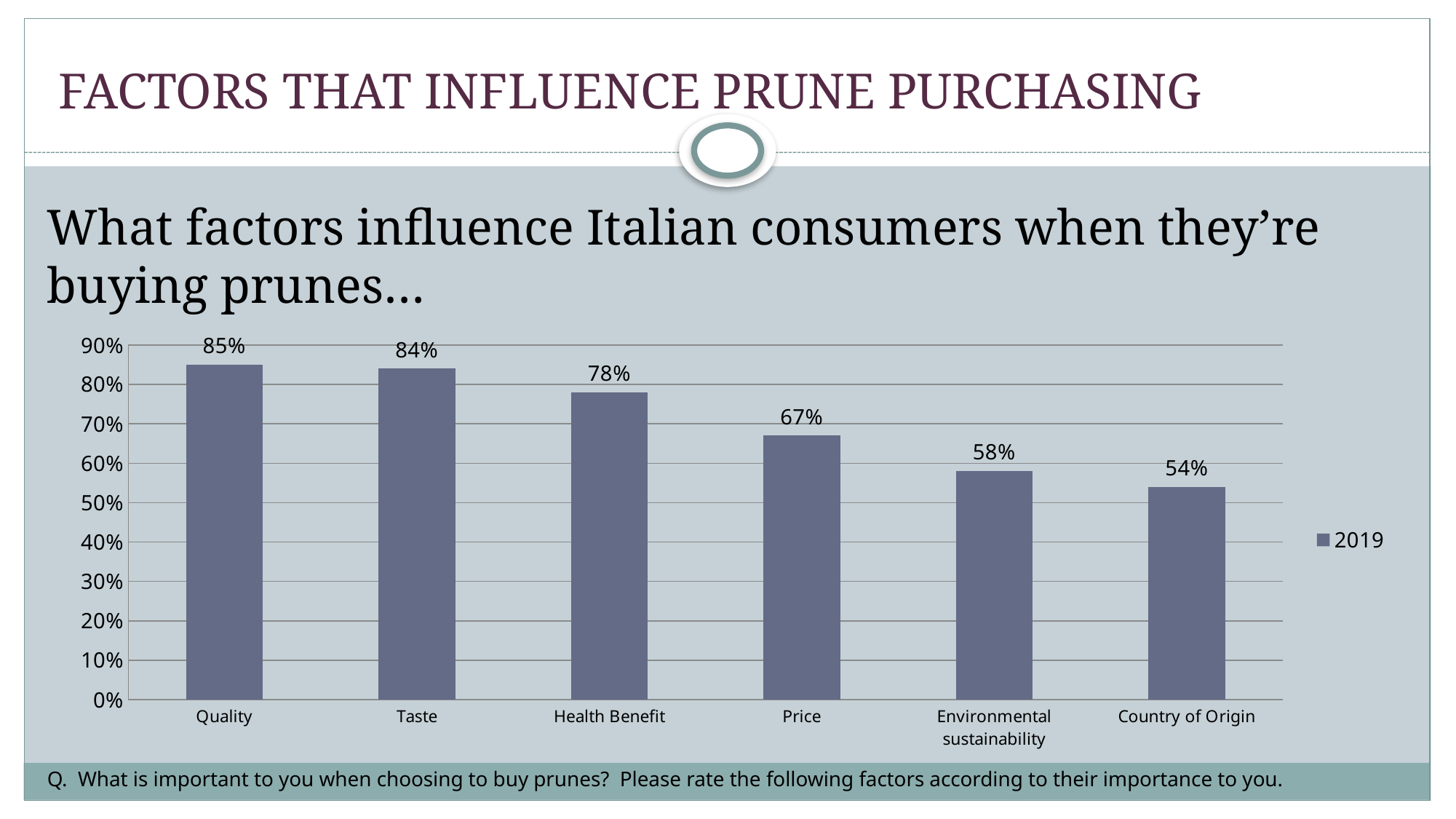
Which factor has the highest value? Quality Is the value for Country of Origin greater or less than 60%? less Which is larger, the value for Taste or the value for Price? Taste What series name appears in the legend? 2019 What is the difference between the values for Quality and Price? 18% What is the value for Health Benefit? 78% Which factor has the lowest value? Country of Origin What is the value for Quality? 85% What kind of chart is shown? bar chart How many factors are shown on the x axis? 6 How many series does the legend list? 1 What is the value for Environmental sustainability? 58%